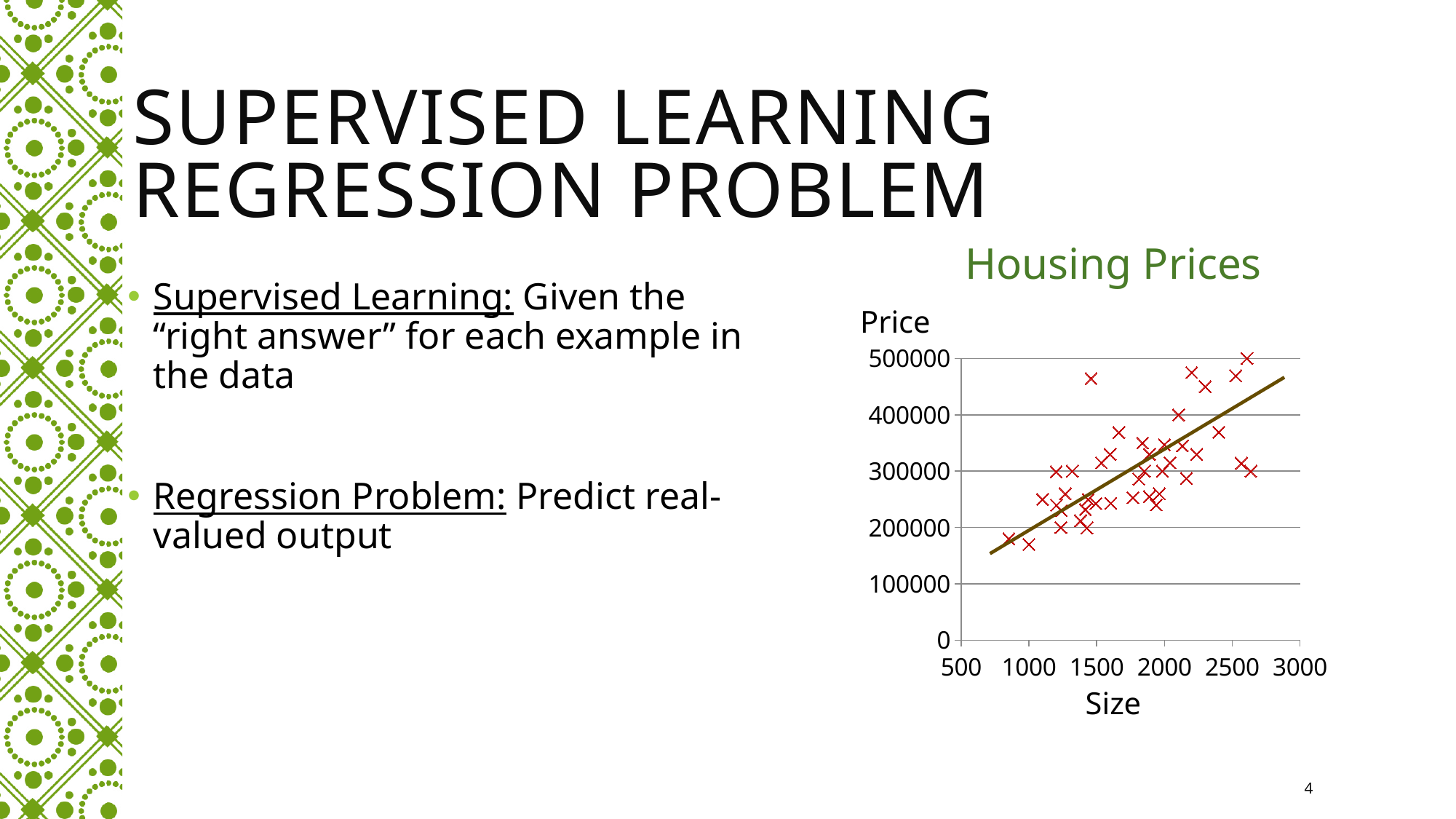
What is the highest value shown on the Price axis? 500000 What is the label of the horizontal axis of the chart? Size What is the title of the chart? Housing Prices Is the lowest plotted price in the chart greater or less than 200000? less Do the plotted prices generally rise or fall as size increases along the x axis? rise What is the lowest value shown on the Size axis? 500 Is the highest plotted price in the chart greater or less than 400000? greater What kind of chart is shown on the slide? scatter chart Does the fitted line in the chart slope upward or downward from left to right? upward